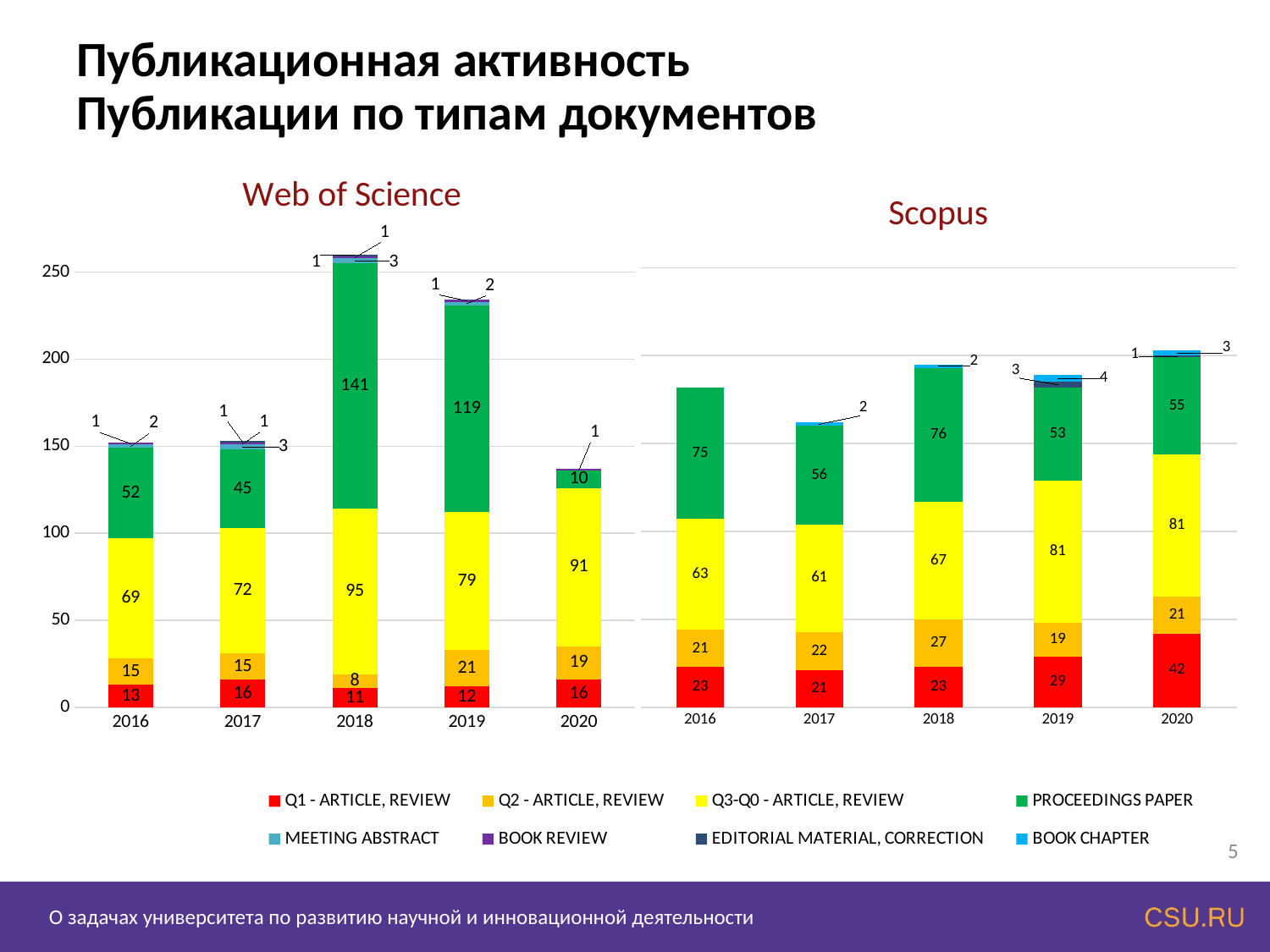
In the Web of Science chart, which year has the highest PROCEEDINGS PAPER value? 2018 In the Scopus chart, what is the PROCEEDINGS PAPER value for 2018? 76 In the Web of Science chart, what is the PROCEEDINGS PAPER value for 2018? 141 In the Scopus chart, what is the Q1 - ARTICLE, REVIEW value for 2020? 42 How many series does the legend list? 8 What kind of chart is the Web of Science chart? Stacked bar chart In the Web of Science chart, what is the Q3-Q0 - ARTICLE, REVIEW value for 2020? 91 In the Scopus chart, which year has the larger Q2 - ARTICLE, REVIEW value, 2018 or 2019? 2018 In the Web of Science chart, is the total height of the 2018 bar greater or less than 250? greater In the Web of Science chart, what is the difference between the Q3-Q0 - ARTICLE, REVIEW values for 2018 and 2016? 26 In the Scopus chart, what is the total of the stacked bar for 2016? 182 In the Scopus chart, which year has the lowest Q1 - ARTICLE, REVIEW value? 2017